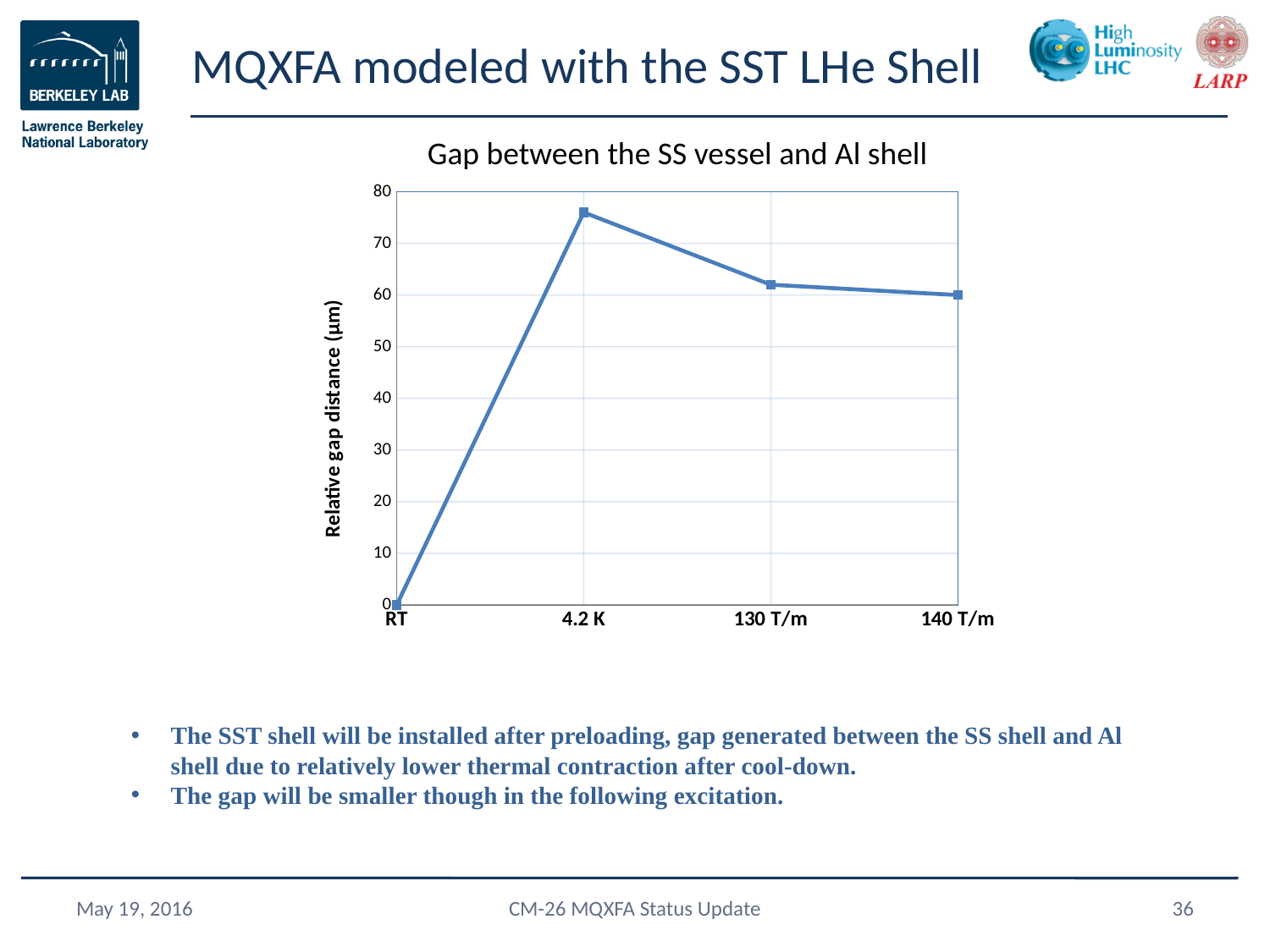
How many points are plotted along the x axis? 4 What is the title of the chart? Gap between the SS vessel and Al shell What is the label of the vertical axis? Relative gap distance (μm) Is the value at 130 T/m greater or less than 70? less Is the value at 4.2 K greater or less than 70? greater Which is larger, the value at 4.2 K or the value at 130 T/m? 4.2 K Is the value at 140 T/m greater or less than 50? greater At which x-axis category is the relative gap distance highest? 4.2 K What is the relative gap distance at RT? 0 At which x-axis category is the relative gap distance lowest? RT What kind of chart is shown on the slide? line chart How does the relative gap distance change from 4.2 K to 140 T/m? it falls